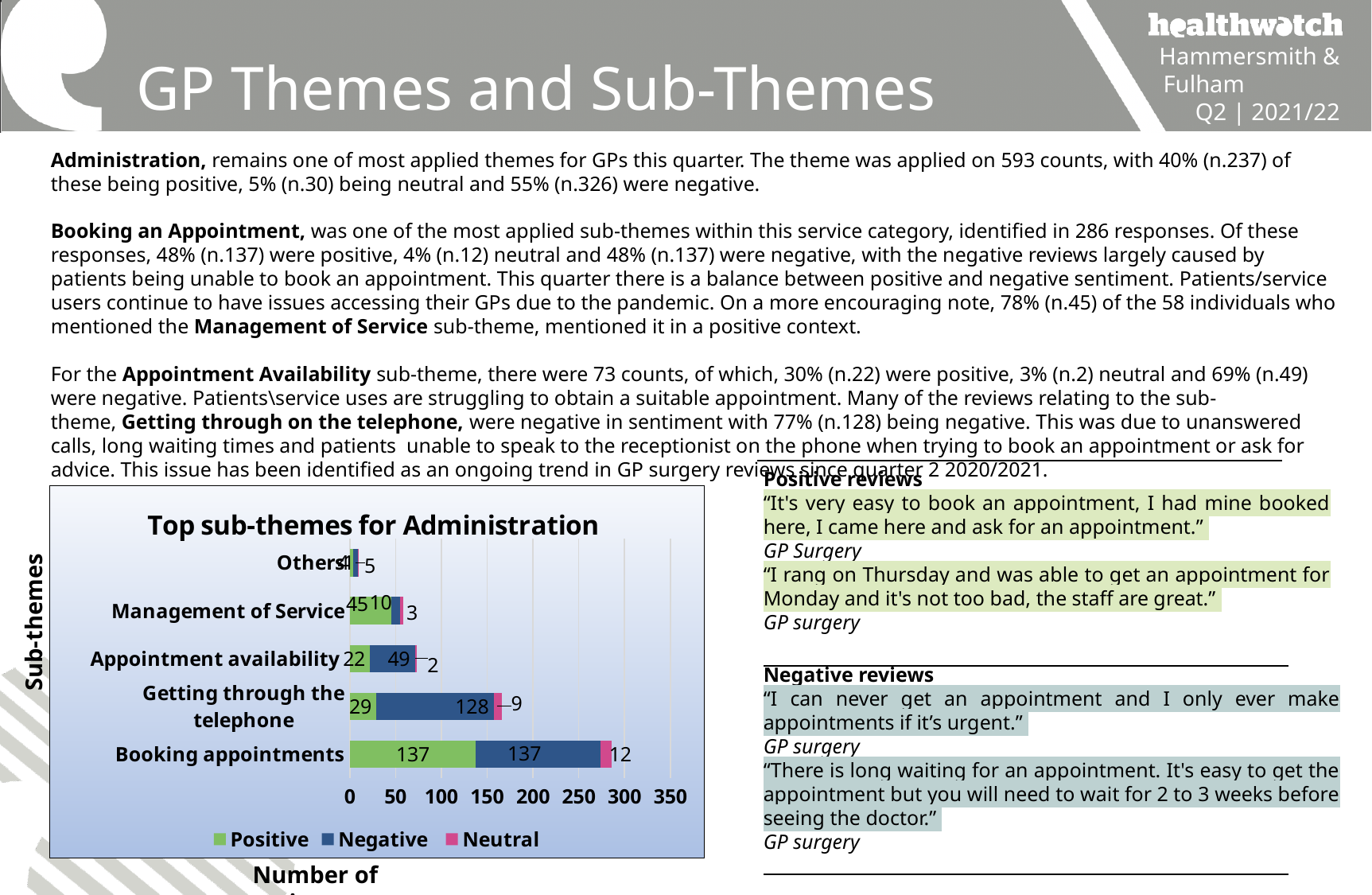
What kind of chart is 'Top sub-themes for Administration'? stacked bar chart What is the Positive value for 'Management of Service' in the 'Top sub-themes for Administration' chart? 45 What is the Neutral value for 'Booking appointments' in the 'Top sub-themes for Administration' chart? 12 In the 'Top sub-themes for Administration' chart, what is the difference between the Negative and Positive values for 'Getting through the telephone'? 99 What is the Negative value for 'Getting through the telephone' in the 'Top sub-themes for Administration' chart? 128 In the 'Top sub-themes for Administration' chart, is the Positive value for 'Appointment availability' larger or smaller than its Negative value? smaller Which series in the 'Top sub-themes for Administration' chart is shown in green? Positive Which sub-theme has the highest Negative value in the 'Top sub-themes for Administration' chart? Booking appointments What is the total of the stacked bar for 'Appointment availability' in the 'Top sub-themes for Administration' chart? 73 How many series does the legend of the 'Top sub-themes for Administration' chart list? 3 How many sub-theme categories are shown in the 'Top sub-themes for Administration' chart? 5 What is the total of the stacked bar for 'Getting through the telephone' in the 'Top sub-themes for Administration' chart? 166